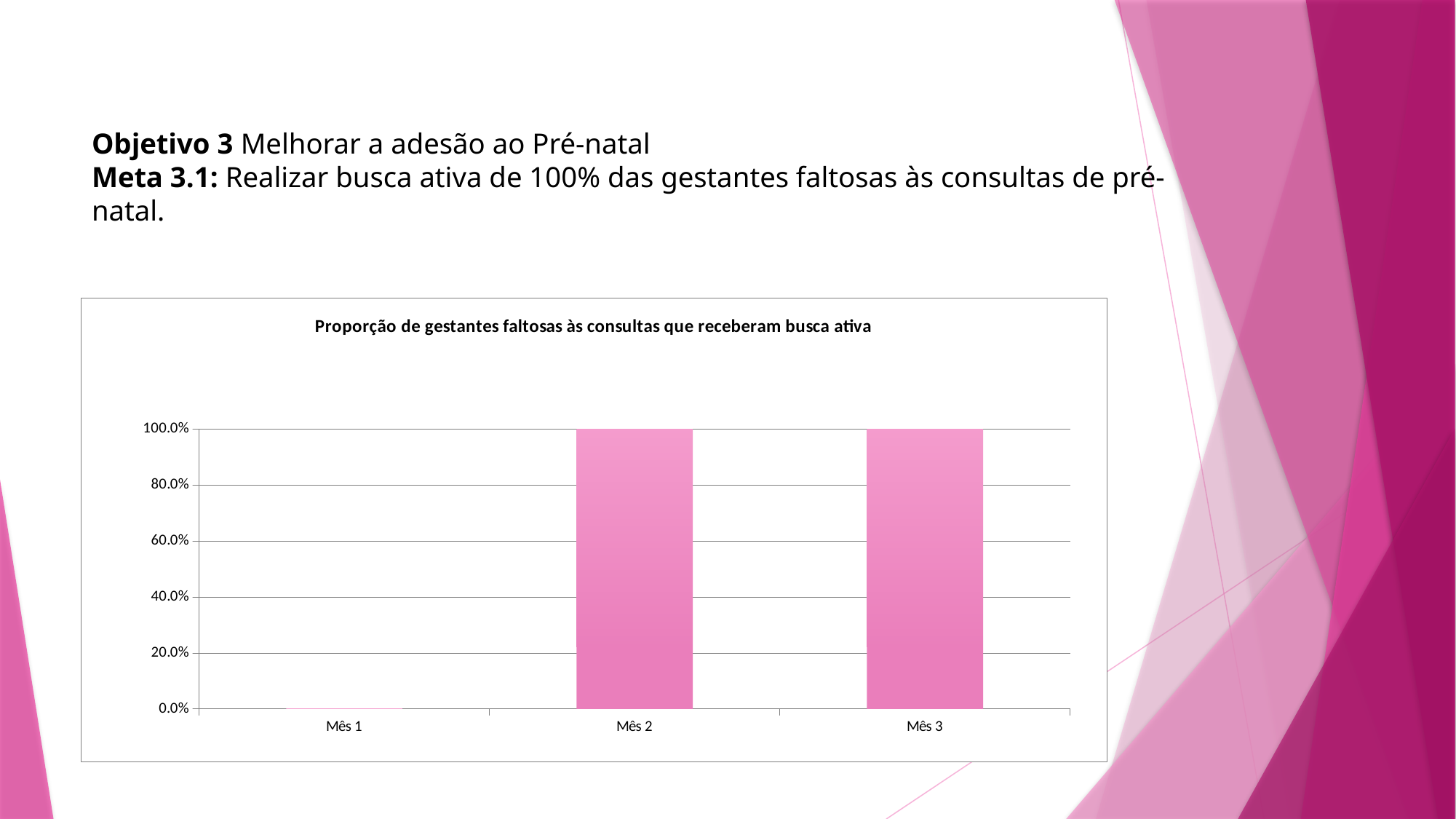
What kind of chart is shown on the slide? bar chart What is the difference between the value for Mês 2 and the value for Mês 1? 100.0% Is the value for Mês 3 greater or less than 80.0%? greater What is the value for Mês 3 in the chart? 100.0% Which is larger, the value for Mês 1 or the value for Mês 2? Mês 2 What is the value for Mês 2 in the chart? 100.0% Which months reach 100.0% in the chart? Mês 2 and Mês 3 What is the title of the chart? Proporção de gestantes faltosas às consultas que receberam busca ativa Which month has the lowest value in the chart? Mês 1 Does the value rise or fall from Mês 1 to Mês 2? rise What is the value for Mês 1 in the chart? 0.0% How many categories (months) are shown on the x axis of the chart? 3